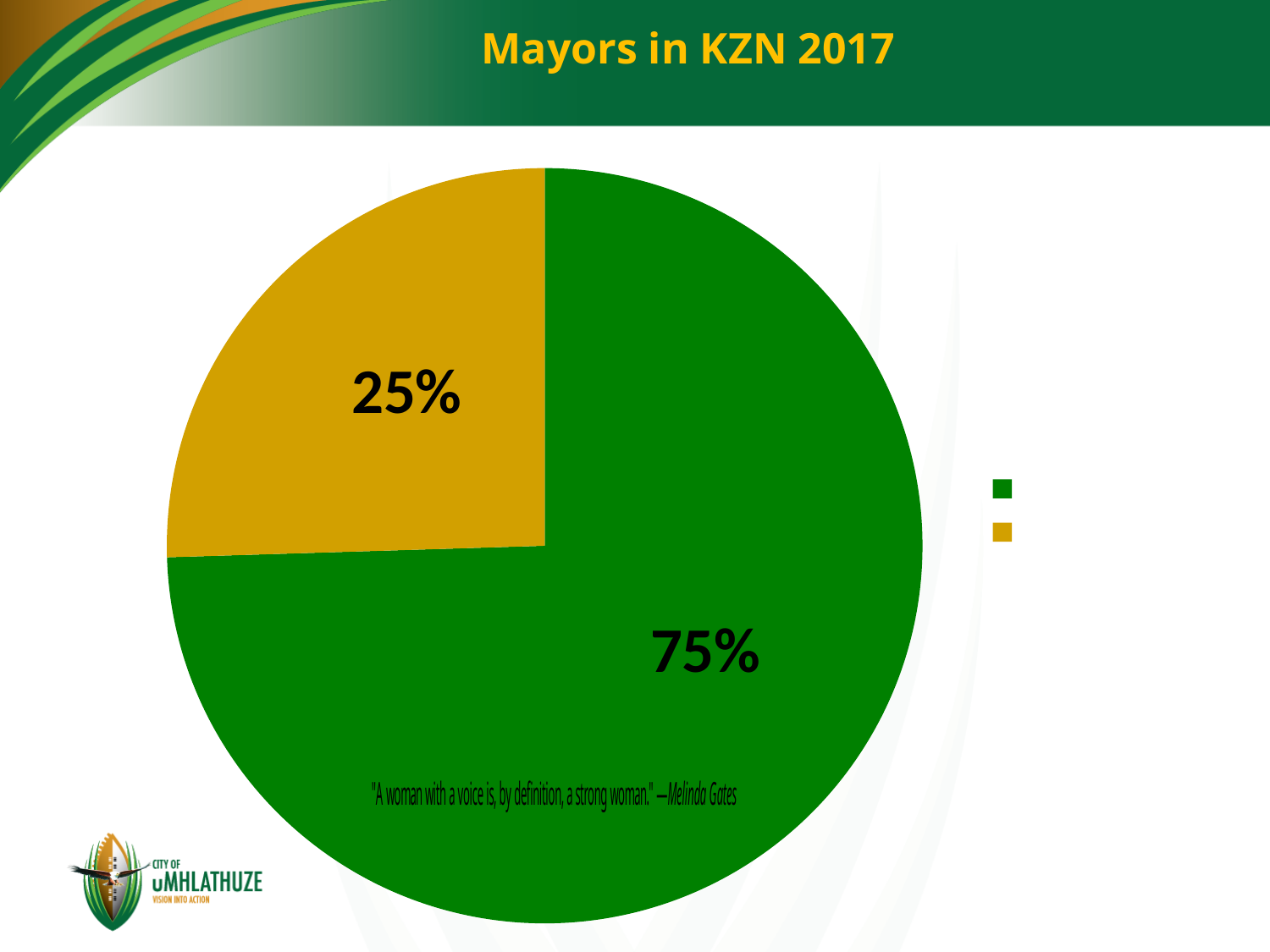
What percentage is shown on the gold slice of the pie chart? 25% Which slice of the pie chart is the largest? the green slice (75%) How many slices does the pie chart have? 2 What percentage is shown on the green slice of the pie chart? 75% What is the title of the chart? Mayors in KZN 2017 By how many percentage points does the green slice exceed the gold slice? 50 percentage points How many entries does the legend list? 2 What kind of chart is shown on the slide? pie chart Which slice of the pie chart is the smallest? the gold slice (25%) Which is larger, the green slice or the gold slice? the green slice What share of the pie does the gold slice represent? 25% What colours are used for the two slices of the pie chart? green and gold